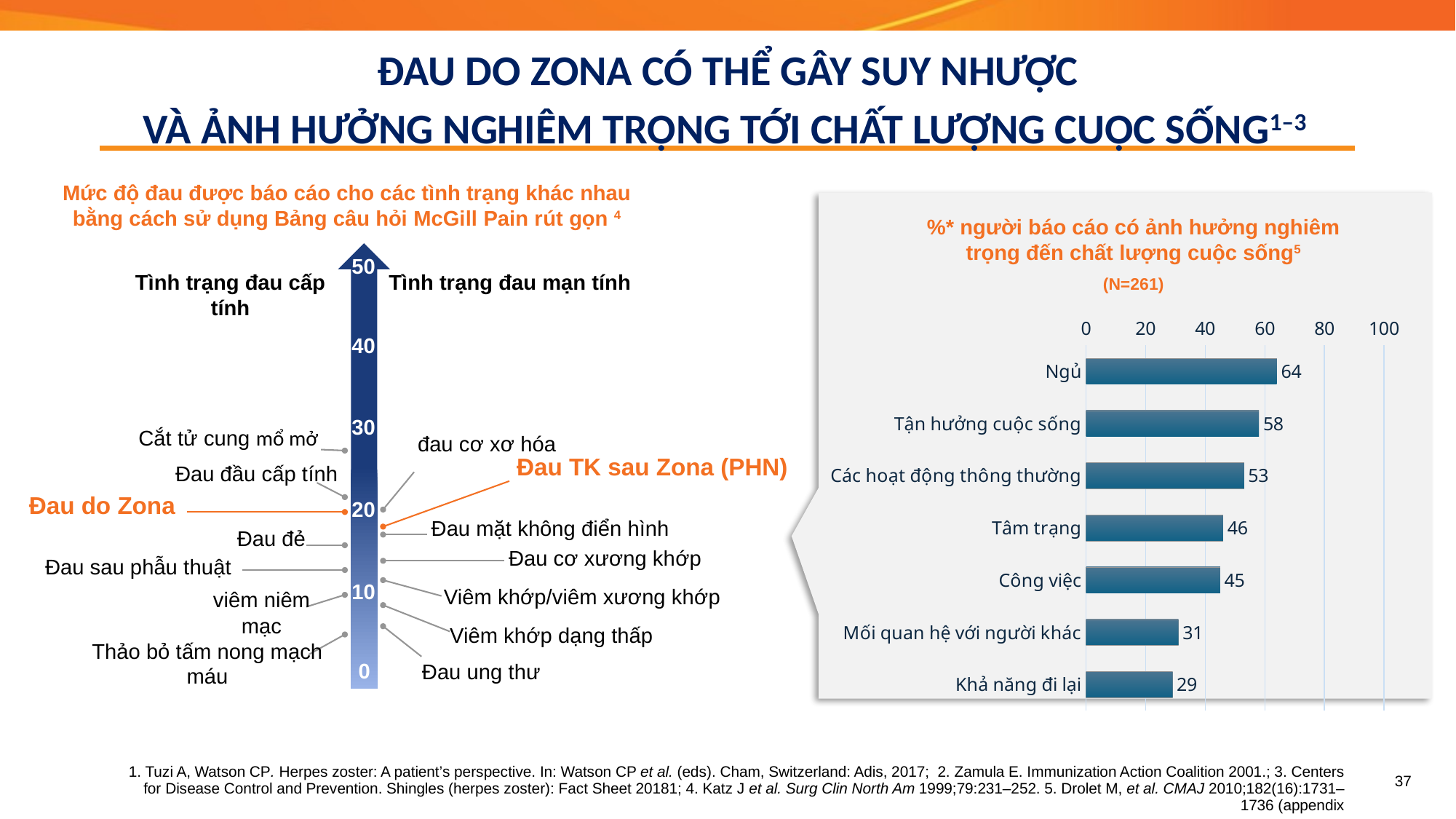
In the bar chart on the right, what percentage reported a serious impact on Ngủ? 64 In the pain scale diagram on the left, is the value for Đau ung thư greater or less than 10? less In the bar chart on the right, which is larger: Tâm trạng or Mối quan hệ với người khác? Tâm trạng In the bar chart on the right, what is the difference between Tận hưởng cuộc sống and Các hoạt động thông thường? 5 In the bar chart on the right, what is the value for Mối quan hệ với người khác? 31 What type of chart is shown on the right side of the slide? Bar chart In the bar chart on the right, how many categories are shown? 7 In the bar chart on the right, which category has the highest value? Ngủ In the bar chart on the right, what is the difference between the values for Ngủ and Khả năng đi lại? 35 In the bar chart on the right, what is the value for Công việc? 45 In the bar chart on the right, which category has the lowest value? Khả năng đi lại In the bar chart on the right, what sample size (N) is stated under the title? N=261